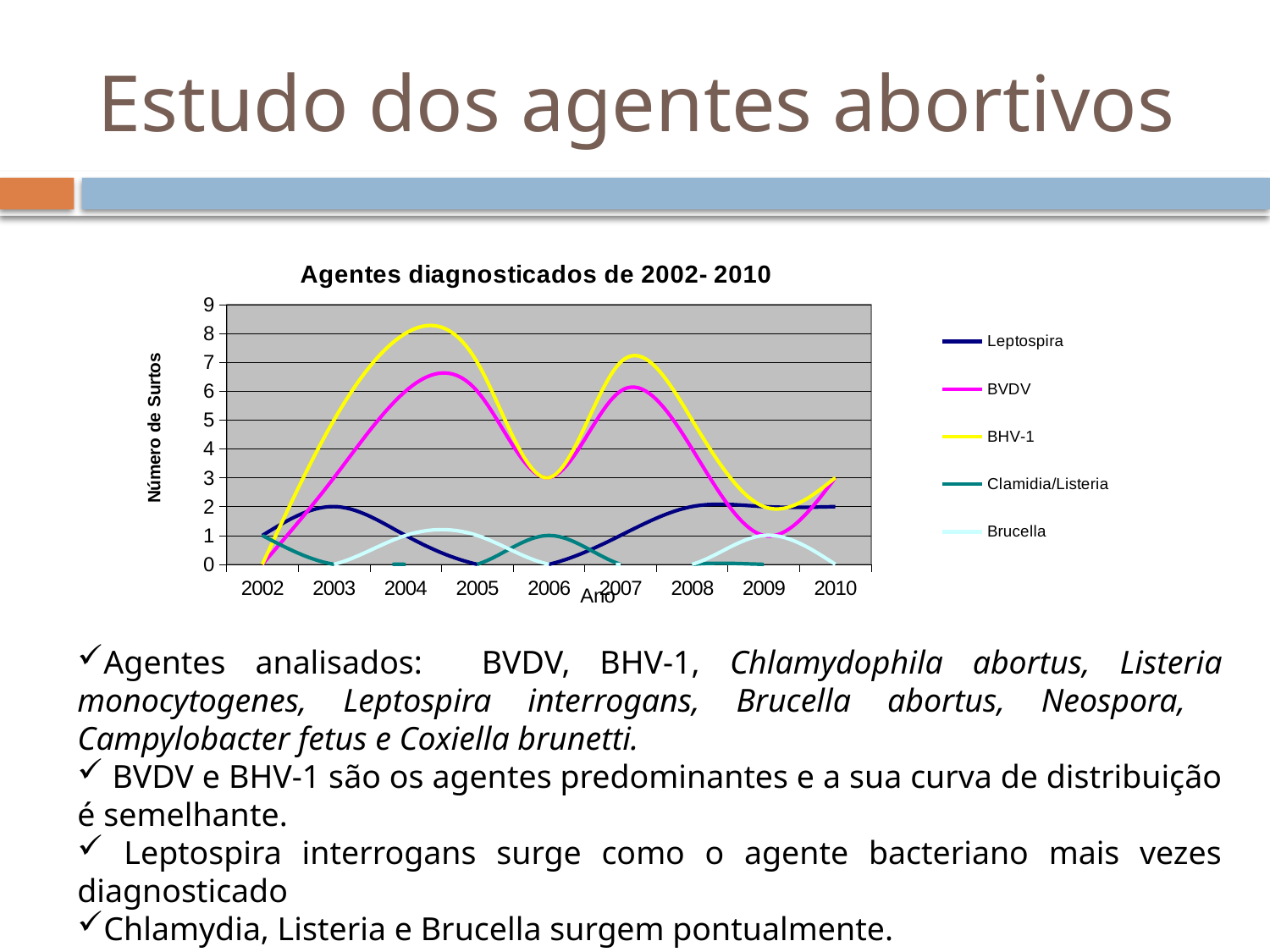
How many series does the legend of the chart list? 5 Does the BVDV line rise or fall from 2007 to 2009? fall In 2004, which series has the larger value, BHV-1 or BVDV? BHV-1 What is the value for BVDV in 2002? 0 Is the value for BHV-1 in 2004 greater or less than 6? greater Which series reaches the highest value on the chart? BHV-1 What is the value for Leptospira in 2010? 2 What is the label of the vertical axis of the chart? Número de Surtos What kind of chart is shown on the slide? line chart How many years are shown on the x axis of the chart? 9 Is the value for BVDV in 2007 greater or less than 5? greater What is the title of the chart? Agentes diagnosticados de 2002- 2010